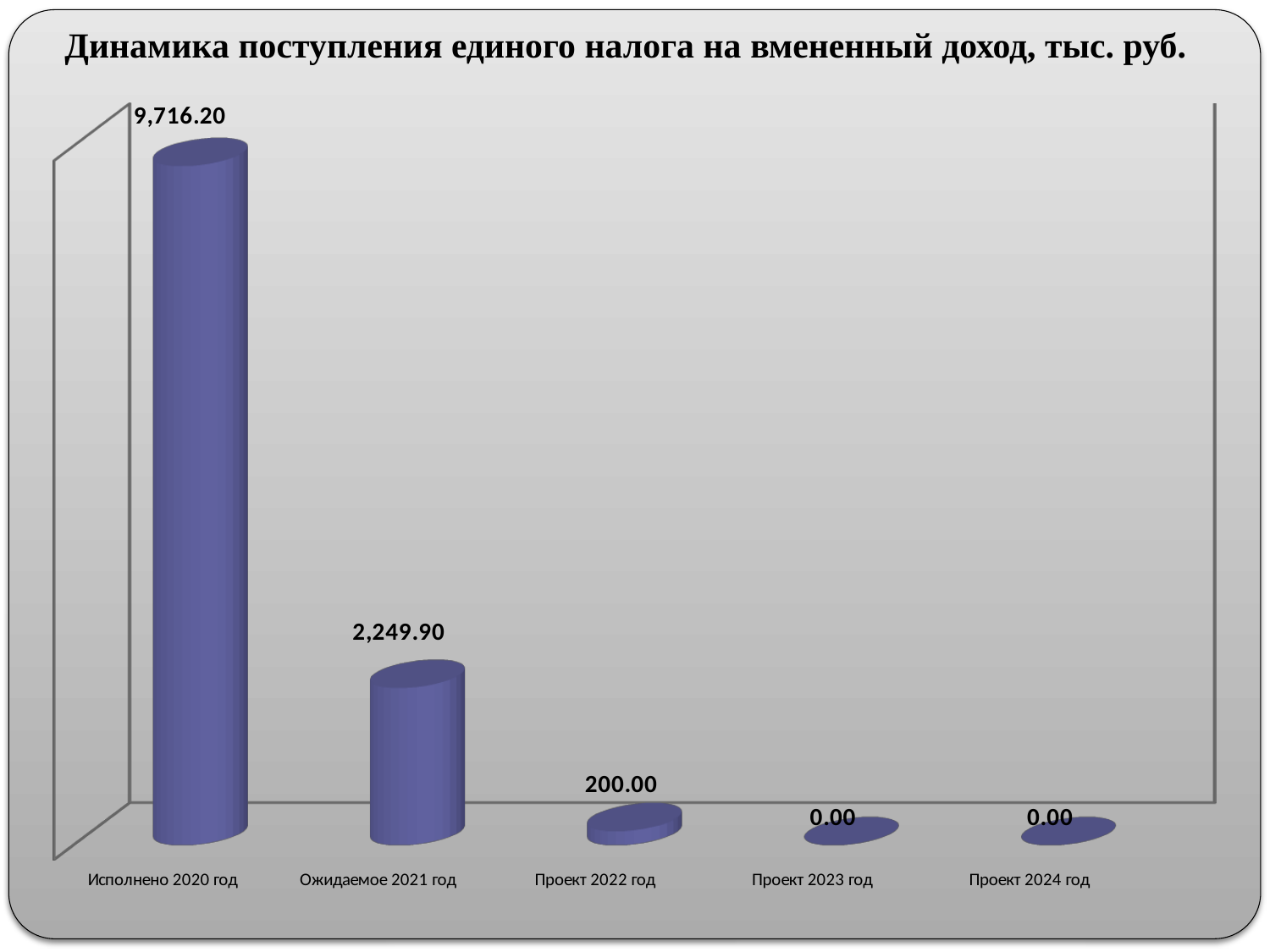
What is the difference between the values for Исполнено 2020 год and Ожидаемое 2021 год? 7,466.30 Do the values rise or fall from left to right along the x axis? fall What is the value for Проект 2023 год? 0.00 What is the value for Ожидаемое 2021 год? 2,249.90 How many categories are shown on the chart? 5 What is the value for Проект 2022 год? 200.00 Which is larger, the value for Ожидаемое 2021 год or the value for Проект 2022 год? Ожидаемое 2021 год What is the value for Исполнено 2020 год? 9,716.20 What is the title of the chart? Динамика поступления единого налога на вмененный доход, тыс. руб. What is the difference between the values for Ожидаемое 2021 год and Проект 2022 год? 2,049.90 Which category has the highest value? Исполнено 2020 год What kind of chart is this? bar chart